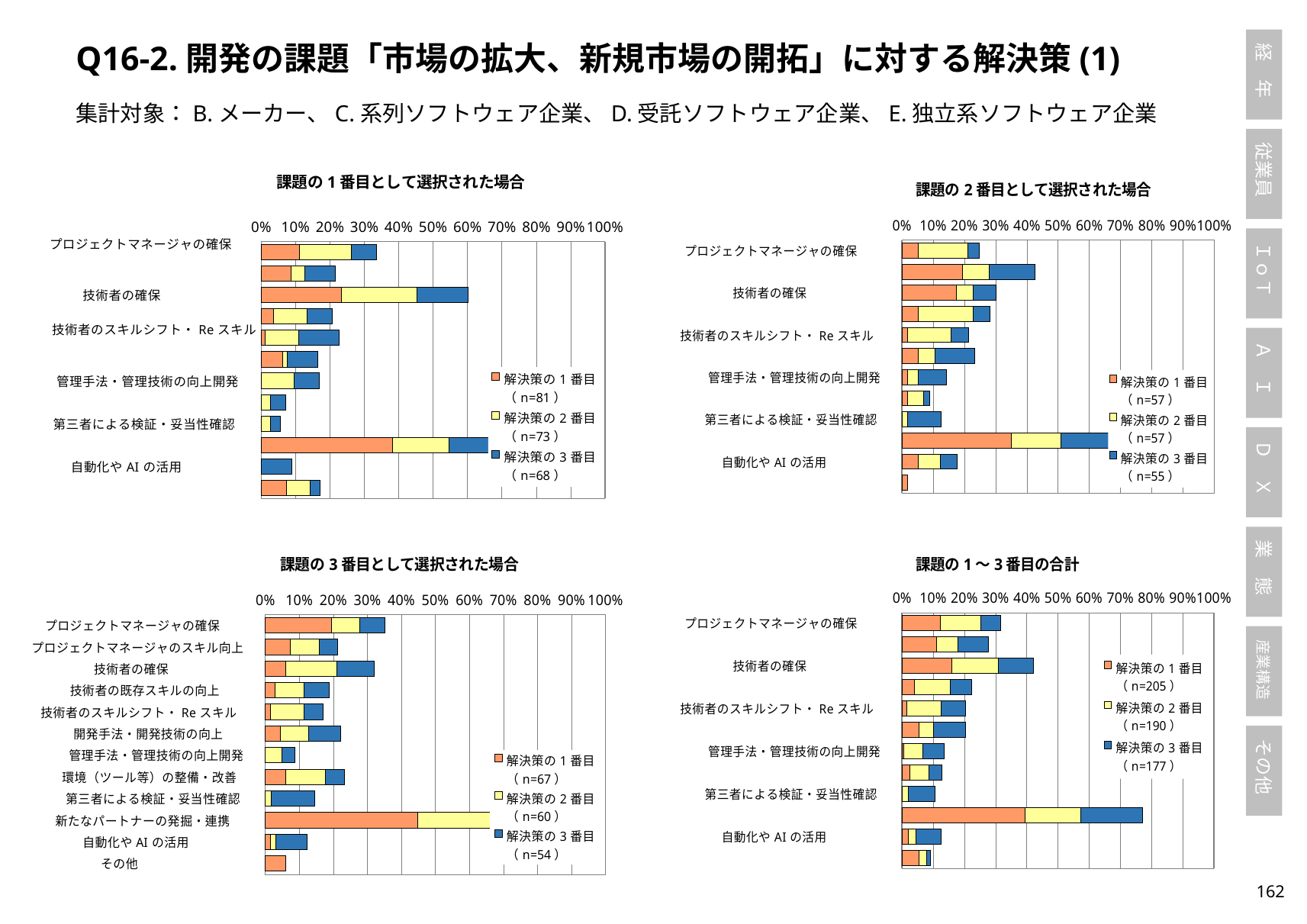
In the chart titled 課題の1～3番目の合計, how many series does the legend list? 3 In the chart titled 課題の3番目として選択された場合, is the total bar for 技術者の確保 greater or less than 40%? less In the chart titled 課題の1～3番目の合計, what n value does the legend give for 解決策の1番目? n=205 In the chart titled 課題の1番目として選択された場合, which has the longer total bar: 技術者の確保 or 第三者による検証・妥当性確認? 技術者の確保 In the chart titled 課題の2番目として選択された場合, is the total bar for 技術者の確保 greater or less than 40%? less In the chart titled 課題の3番目として選択された場合, how many categories are listed on the vertical axis? 12 In the chart titled 課題の1～3番目の合計, which has the longer total bar: 技術者の確保 or 自動化やAIの活用? 技術者の確保 In the chart titled 課題の1番目として選択された場合, is the total bar for 技術者の確保 greater or less than 50%? greater In the chart titled 課題の1番目として選択された場合, what n value does the legend give for 解決策の3番目? n=68 What kind of chart is the chart titled 課題の1番目として選択された場合? stacked bar chart